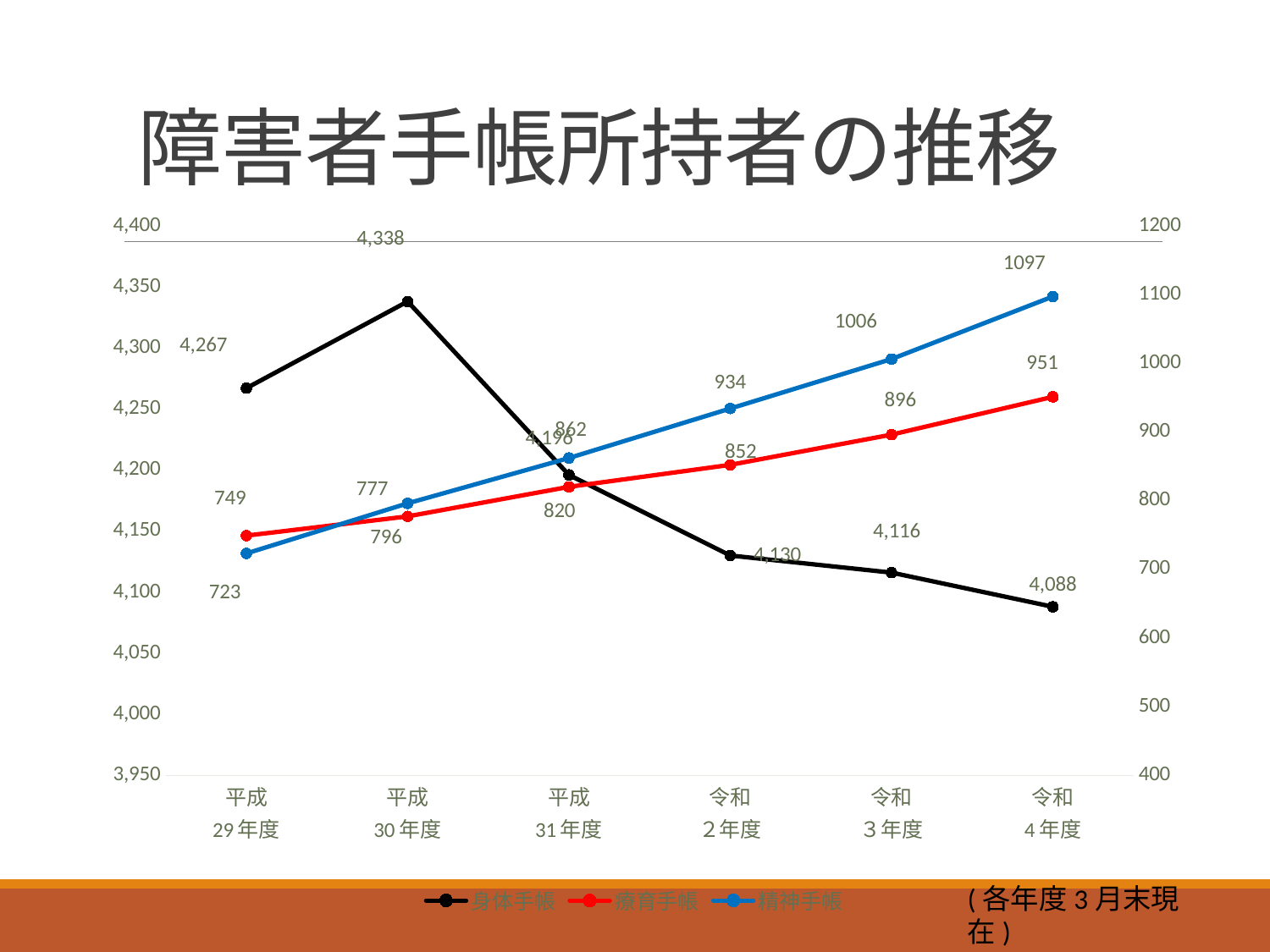
What is the value of 身体手帳 in 平成30年度? 4,338 Which series is drawn in red? 療育手帳 What is the value of 精神手帳 in 令和4年度? 1097 What type of chart is shown on the slide? line chart Does 精神手帳 rise or fall from 平成29年度 to 令和4年度? rise What is the value of 療育手帳 in 令和2年度? 852 In which fiscal year is 精神手帳 at its lowest? 平成29年度 How many series does the legend list? 3 What is the difference between the 身体手帳 values in 平成29年度 and 令和4年度? 179 How many fiscal years are plotted along the x axis? 6 Which is larger in 令和3年度, 療育手帳 or 精神手帳? 精神手帳 In which fiscal year is 身体手帳 at its highest? 平成30年度